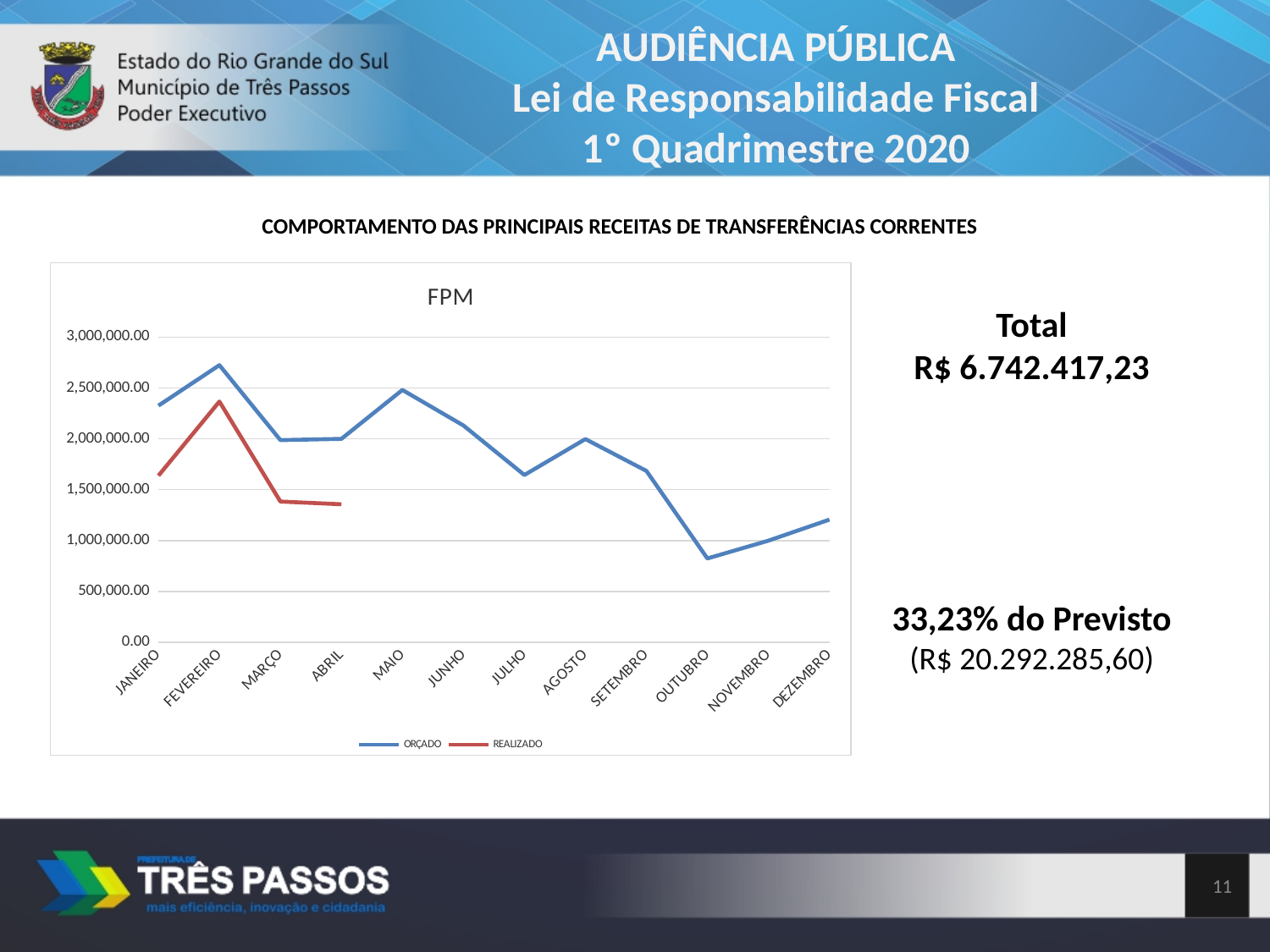
How many months are shown on the x axis of the chart? 12 In which month does the ORÇADO series reach its lowest value? OUTUBRO What kind of chart is shown on the slide? line chart Does the REALIZADO series rise or fall from FEVEREIRO to MARÇO? fall How many series does the chart legend list? 2 In JANEIRO, which series has the larger value, ORÇADO or REALIZADO? ORÇADO In which month does the REALIZADO series reach its highest value? FEVEREIRO Is the ORÇADO value for OUTUBRO greater or less than 1,000,000.00? less In which month does the ORÇADO series reach its highest value? FEVEREIRO Is the REALIZADO value for FEVEREIRO greater or less than 2,000,000.00? greater Which series is drawn in red in the chart? REALIZADO What is the title of the chart? FPM